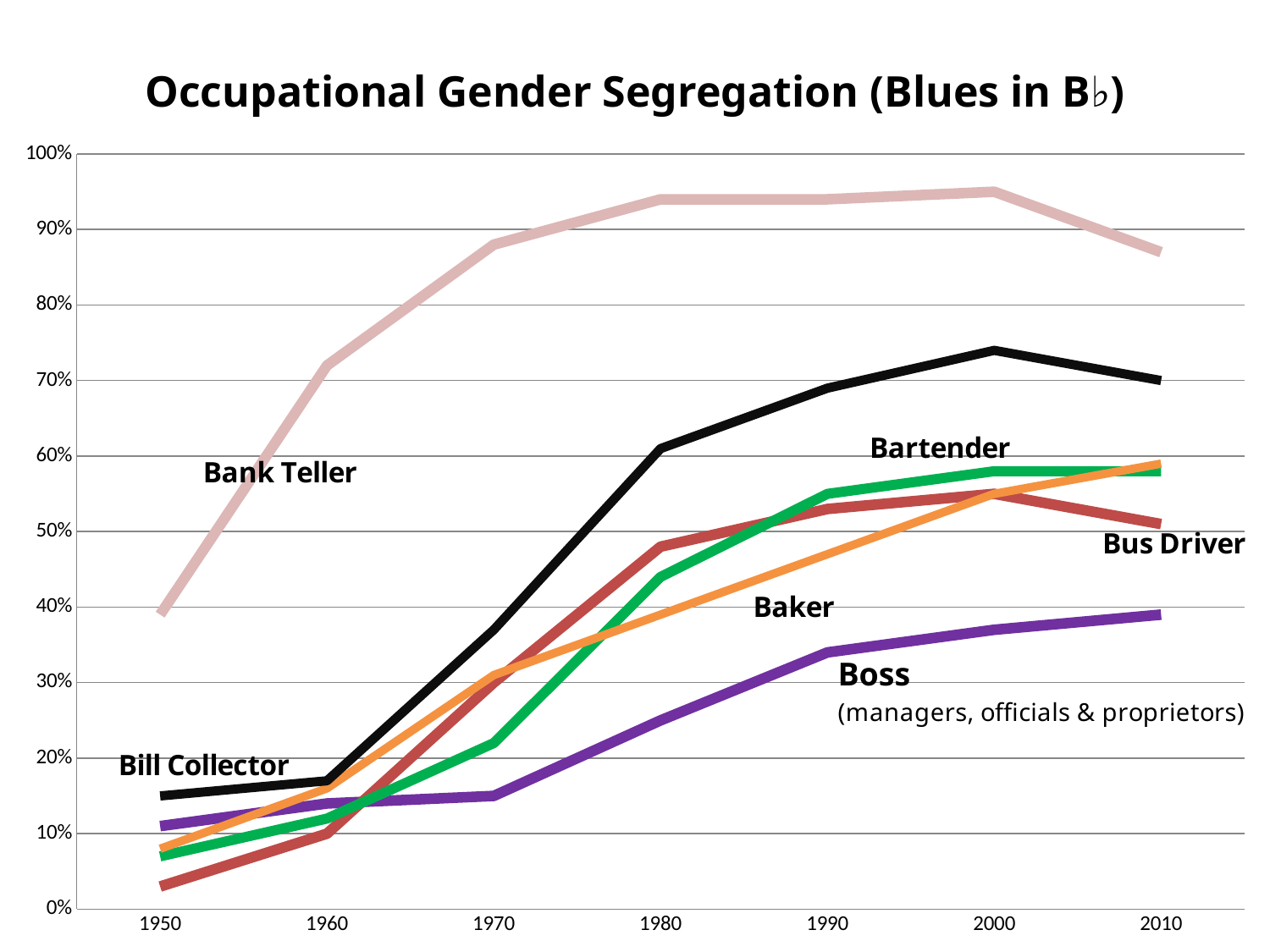
What is the title of the chart? Occupational Gender Segregation (Blues in B♭) Does the Bank Teller line rise or fall from 1950 to 2000? rise In 2010, which is larger: the value for Bill Collector or the value for Bartender? Bill Collector Is the value for Boss in 2010 greater or less than 30%? greater What kind of chart is shown on the slide? line chart Is the value for Bank Teller in 1980 greater or less than 90%? greater Which occupation has the highest value in 2010? Bank Teller Which occupation has the lowest value in 2010? Boss Is the value for Bill Collector in 2000 greater or less than 70%? greater How many years are plotted along the x axis? 7 Which occupation has the lowest value in 1950? Bus Driver